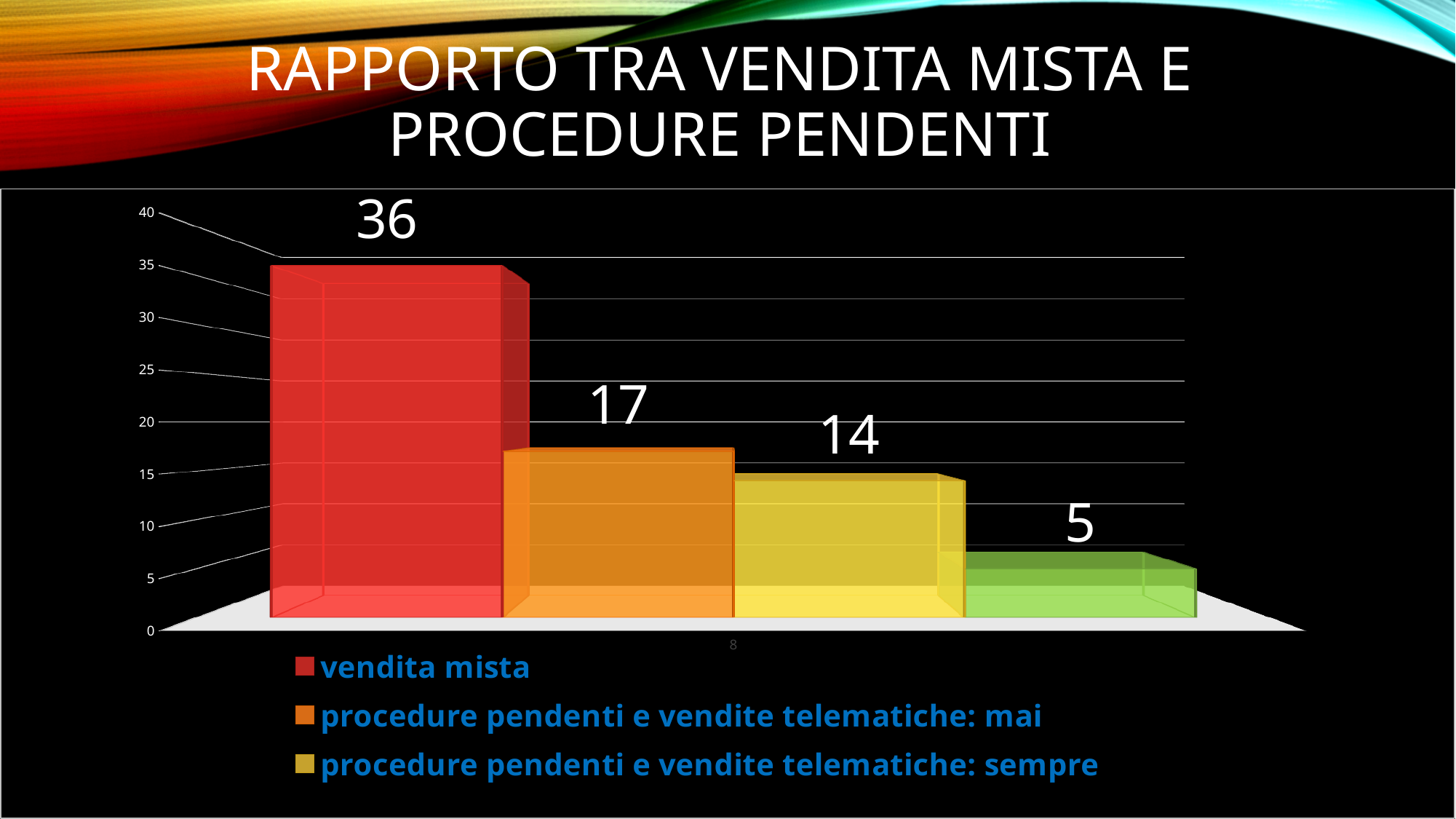
Which is larger, procedure pendenti e vendite telematiche: mai or procedure pendenti e vendite telematiche: sempre? procedure pendenti e vendite telematiche: mai What is the difference between vendita mista and procedure pendenti e vendite telematiche: mai? 19 What is the value for procedure pendenti e vendite telematiche: mai? 17 What kind of chart is shown on the slide? bar chart What is the difference between procedure pendenti e vendite telematiche: mai and procedure pendenti e vendite telematiche: sempre? 3 How many entries does the legend list? 3 What is the value for procedure pendenti e vendite telematiche: sempre? 14 Which series has the highest value? vendita mista How many bars are plotted on the chart? 4 What is the value for vendita mista? 36 What is the lowest value shown on the chart? 5 Is the value for vendita mista greater or less than 30? greater